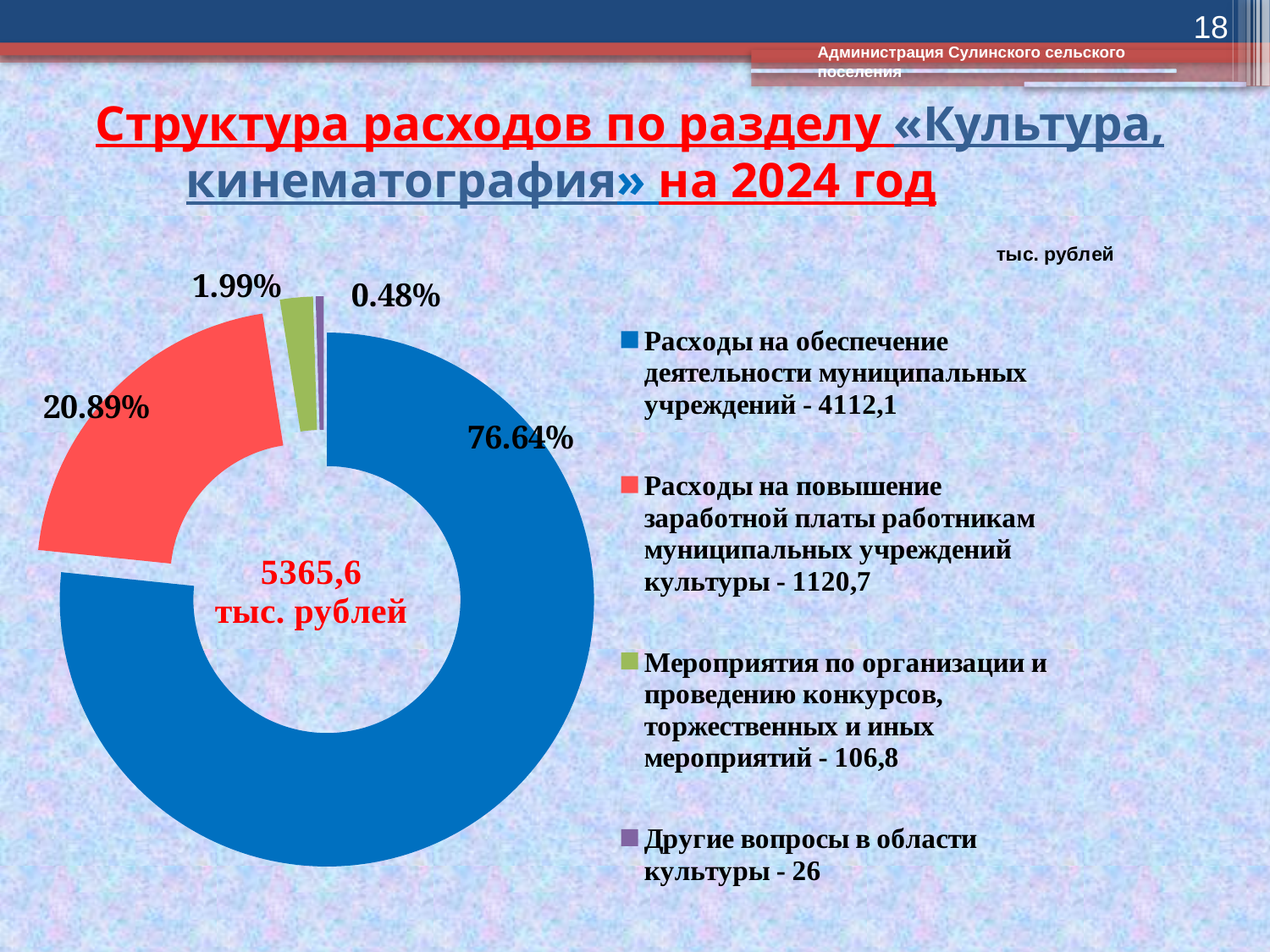
What is the value (тыс. рублей) for «Расходы на обеспечение деятельности муниципальных учреждений»? 4112,1 What share of the chart does the slice for «Мероприятия по организации и проведению конкурсов, торжественных и иных мероприятий» represent? 1.99% What is the value (тыс. рублей) for «Другие вопросы в области культуры»? 26 What share of the chart does the slice for «Другие вопросы в области культуры» represent? 0.48% What share of the chart does the slice for «Расходы на обеспечение деятельности муниципальных учреждений» represent? 76.64% Which category has the largest slice of the chart? Расходы на обеспечение деятельности муниципальных учреждений What kind of chart is shown on the slide? Doughnut (pie) chart Which category has the smallest slice of the chart? Другие вопросы в области культуры What is the value (тыс. рублей) for «Расходы на повышение заработной платы работникам муниципальных учреждений культуры»? 1120,7 How many categories does the chart show? 4 What is the total shown in the centre of the chart? 5365,6 тыс. рублей